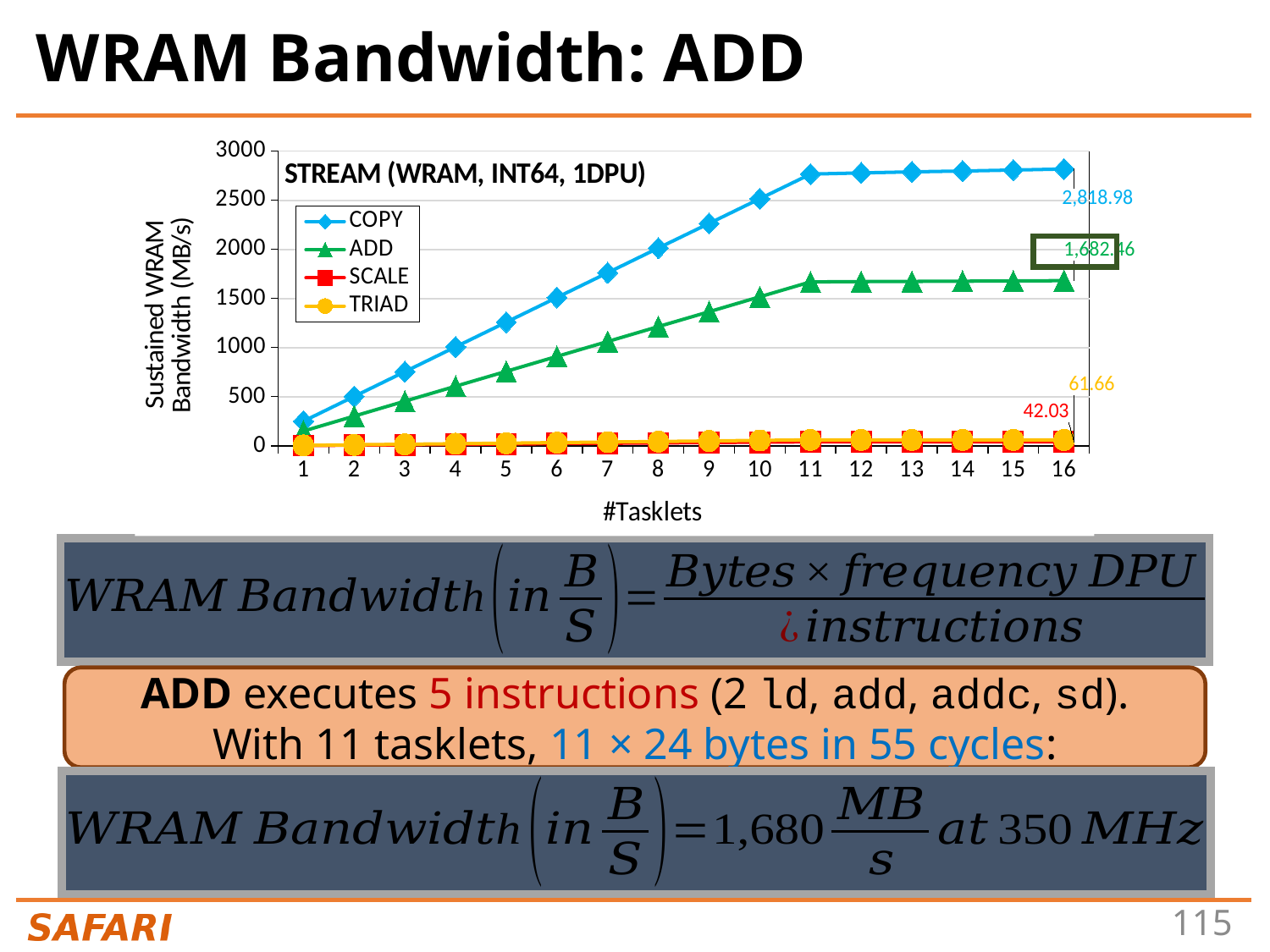
What is the SCALE bandwidth at 16 tasklets? 42.03 What kind of chart is shown on the slide? line chart At 16 tasklets, which is larger: the TRIAD bandwidth or the SCALE bandwidth? TRIAD What is the TRIAD bandwidth at 16 tasklets? 61.66 Which series has the highest sustained WRAM bandwidth at 16 tasklets? COPY Which series has the lowest sustained WRAM bandwidth at 16 tasklets? SCALE How many tasklet counts are plotted along the x axis? 16 What is the difference between the TRIAD and SCALE bandwidths at 16 tasklets? 19.63 What is the title shown inside the chart area? STREAM (WRAM, INT64, 1DPU) How many series does the chart legend list? 4 Is the ADD bandwidth at 8 tasklets greater or less than 1000? greater What is the COPY bandwidth at 16 tasklets? 2,818.98